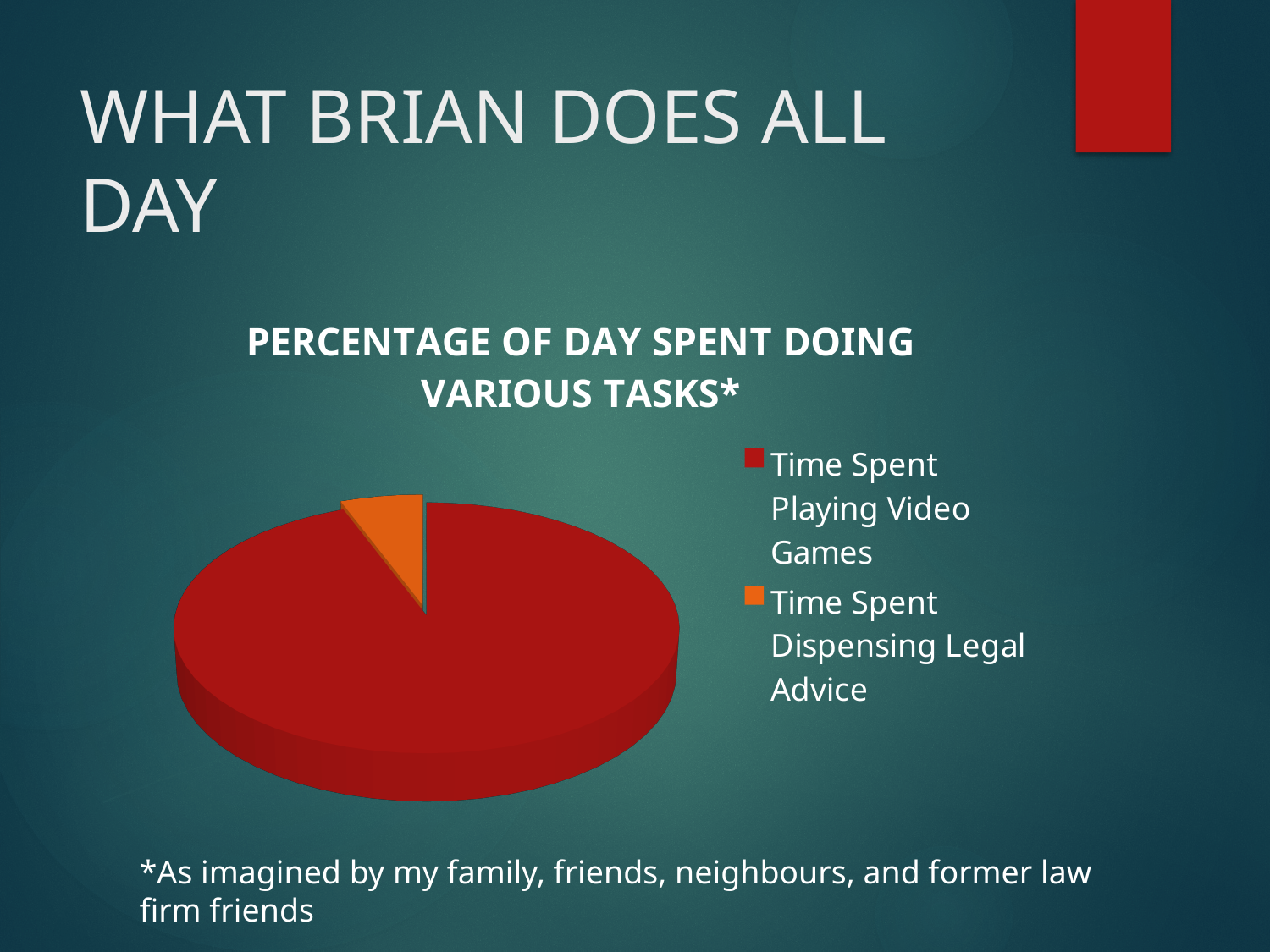
Which category takes up the smallest share of the pie chart? Time Spent Dispensing Legal Advice What kind of chart is shown on the slide? Pie chart How many slices does the pie chart have? 2 Which category takes up the largest share of the pie chart? Time Spent Playing Video Games Which is larger in the pie chart: Time Spent Playing Video Games or Time Spent Dispensing Legal Advice? Time Spent Playing Video Games How many entries does the legend of the pie chart list? 2 What is the title of the pie chart? PERCENTAGE OF DAY SPENT DOING VARIOUS TASKS* What colour is the slice for Time Spent Dispensing Legal Advice? Orange